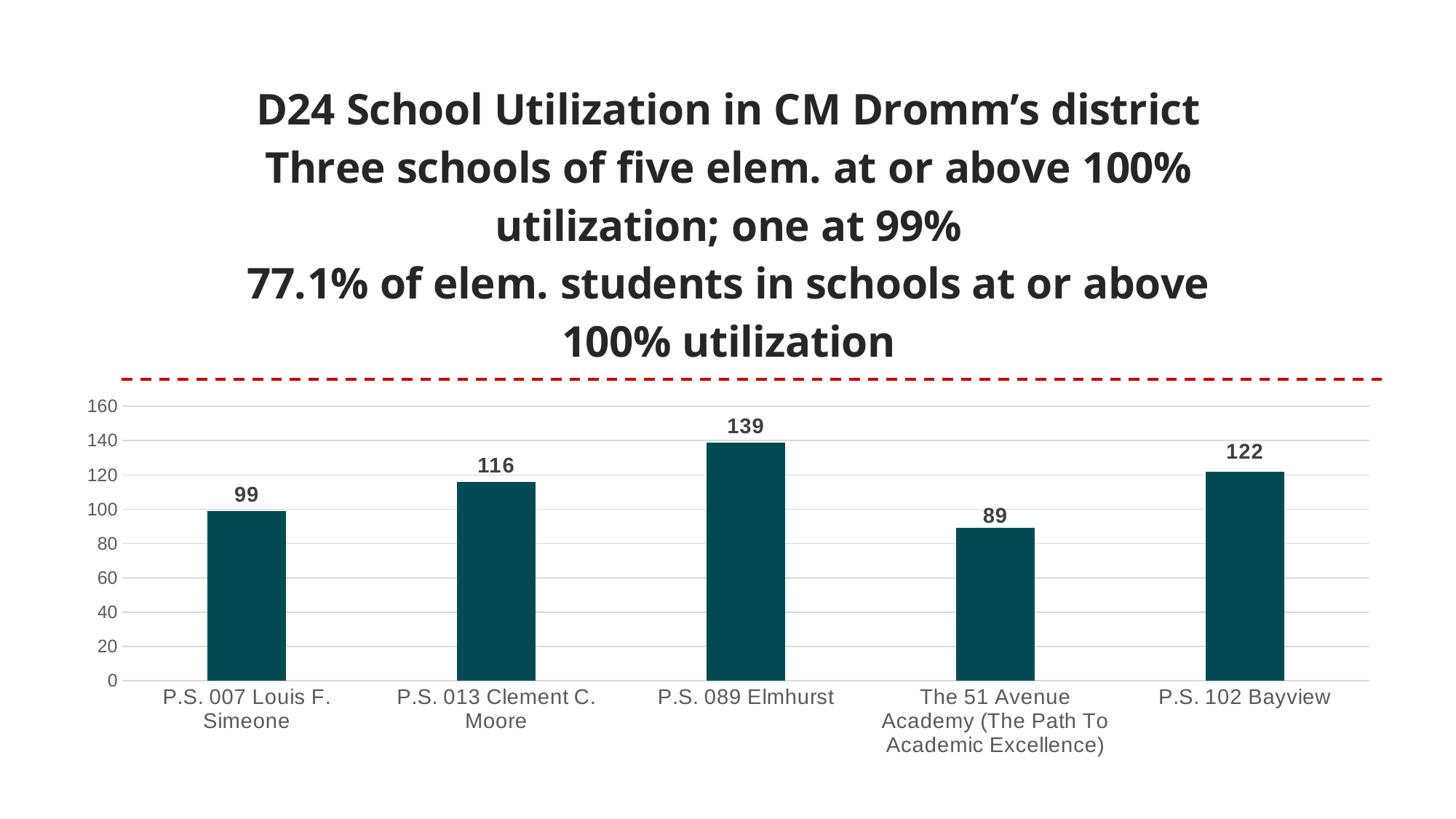
What is the highest value shown on the vertical axis? 160 Is the value for P.S. 089 Elmhurst greater or less than 120? greater What kind of chart is shown on the slide? bar chart What is the value for P.S. 013 Clement C. Moore? 116 What is the value for P.S. 102 Bayview? 122 Which school has the lowest value? The 51 Avenue Academy (The Path To Academic Excellence) What is the difference between the values for P.S. 089 Elmhurst and P.S. 102 Bayview? 17 Which is larger, the value for P.S. 013 Clement C. Moore or the value for P.S. 102 Bayview? P.S. 102 Bayview What is the value for The 51 Avenue Academy (The Path To Academic Excellence)? 89 What is the value for P.S. 007 Louis F. Simeone? 99 Which school has the highest value? P.S. 089 Elmhurst How many schools are shown on the chart? 5